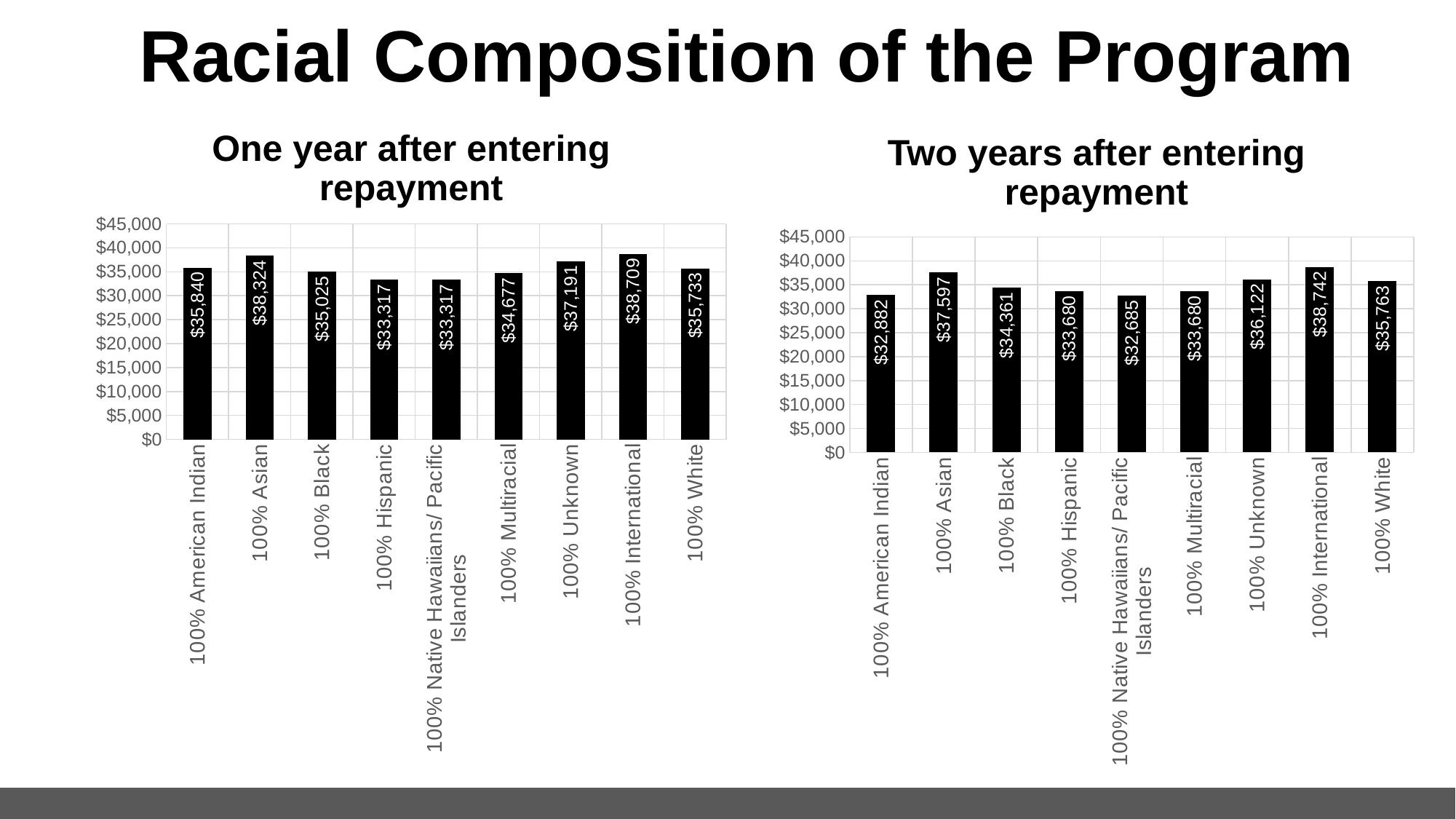
In the 'Two years after entering repayment' chart, which is larger: the value for 100% Asian or the value for 100% Unknown? 100% Asian In the 'Two years after entering repayment' chart, which category has the lowest value? 100% Native Hawaiians/ Pacific Islanders How many categories are shown in the 'Two years after entering repayment' chart? 9 In the 'Two years after entering repayment' chart, what is the value for 100% American Indian? $32,882 In the 'One year after entering repayment' chart, what is the value for 100% Asian? $38,324 In the 'One year after entering repayment' chart, which category has the highest value? 100% International What is the title of the slide? Racial Composition of the Program In the 'One year after entering repayment' chart, what is the difference between the values for 100% International and 100% Hispanic? $5,392 In the 'One year after entering repayment' chart, is the value for 100% Black greater or less than $40,000? less What kind of chart is the 'One year after entering repayment' chart? bar chart In the 'One year after entering repayment' chart, what is the difference between the values for 100% Asian and 100% White? $2,591 In the 'Two years after entering repayment' chart, what is the value for 100% White? $35,763